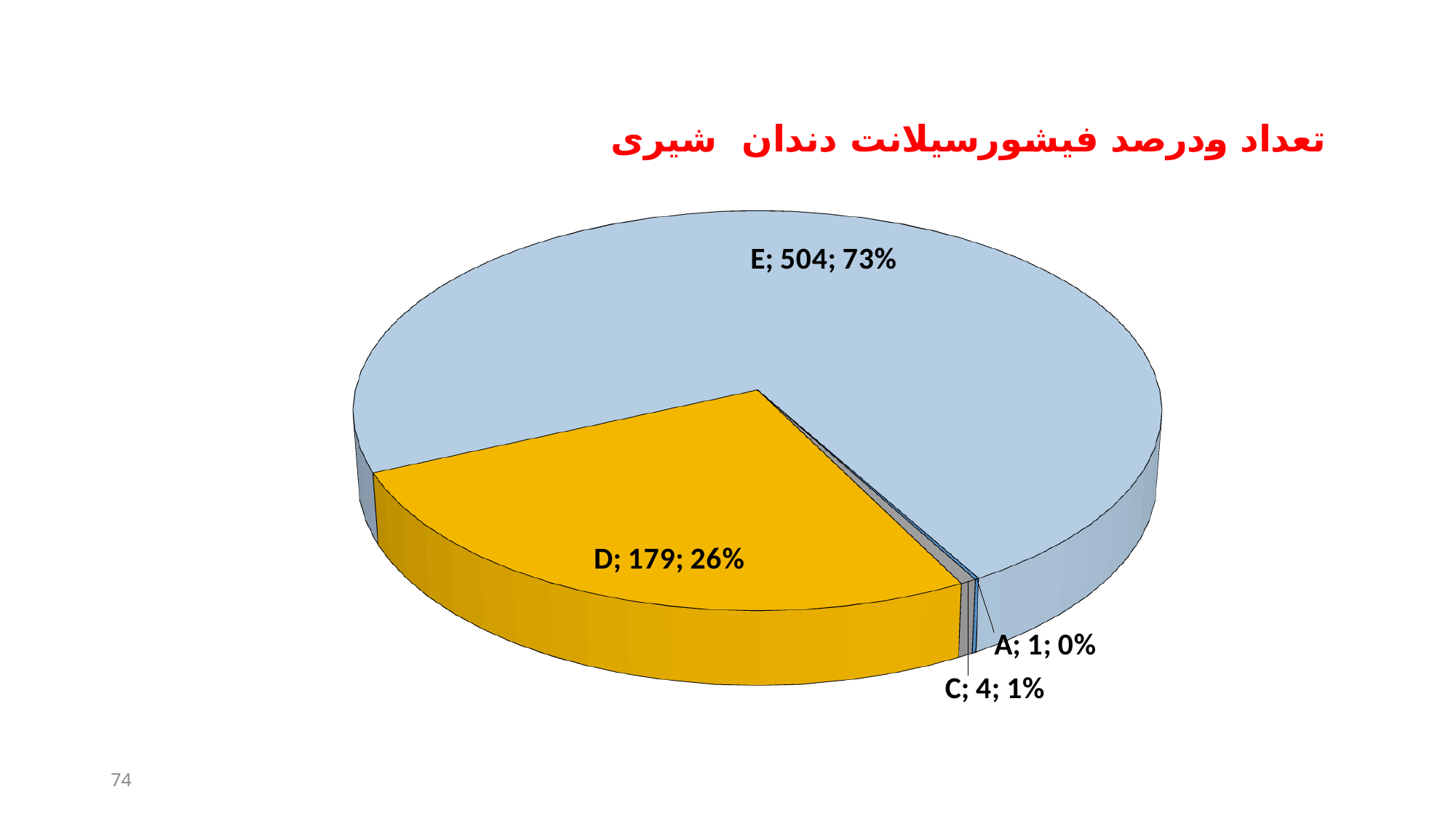
Which category has the largest slice? E What is the value for category A? 1 What share of the pie does category E represent? 73% Which is larger, the value for D or the value for C? D What kind of chart is shown on the slide? pie chart What is the difference between the values for E and D? 325 How many slices does the pie chart have? 4 What is the value for category C? 4 Which category has the smallest slice? A What is the value for category D? 179 What is the value for category E? 504 What share of the pie does category D represent? 26%